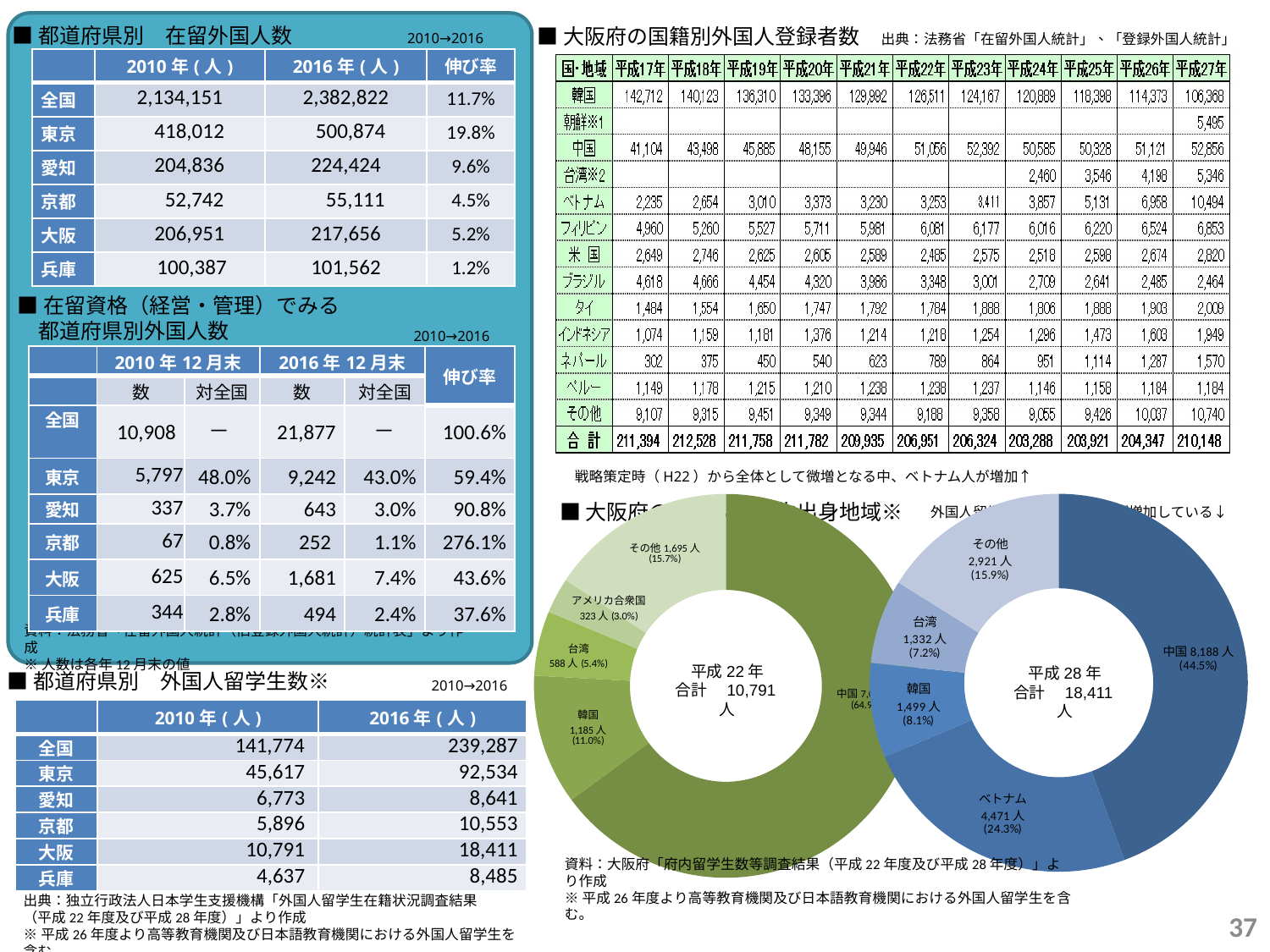
What kind of chart is used to show the 出身地域 breakdown at the bottom right of the slide? Pie (donut) chart In the left donut chart (平成22年), what share of the total is 韓国? 11.0% In the left donut chart (平成22年), what share of the total is アメリカ合衆国? 3.0% In the right donut chart (平成28年), which is larger, 台湾 or 韓国? 韓国 In the right donut chart (平成28年), what share of the total is ベトナム? 24.3% In the right donut chart (平成28年), which labelled category has the smallest slice? 台湾 What is the total (合計) shown in the centre of the right donut chart (平成28年)? 18,411人 What is the total (合計) shown in the centre of the left donut chart (平成22年)? 10,791人 In the right donut chart (平成28年), what is the difference between the 中国 and ベトナム values? 3,717人 In the right donut chart (平成28年), which category has the largest slice? 中国 In the left donut chart (平成22年), how many people are in the その他 category? 1,695人 In the right donut chart (平成28年), how many people are from 中国? 8,188人